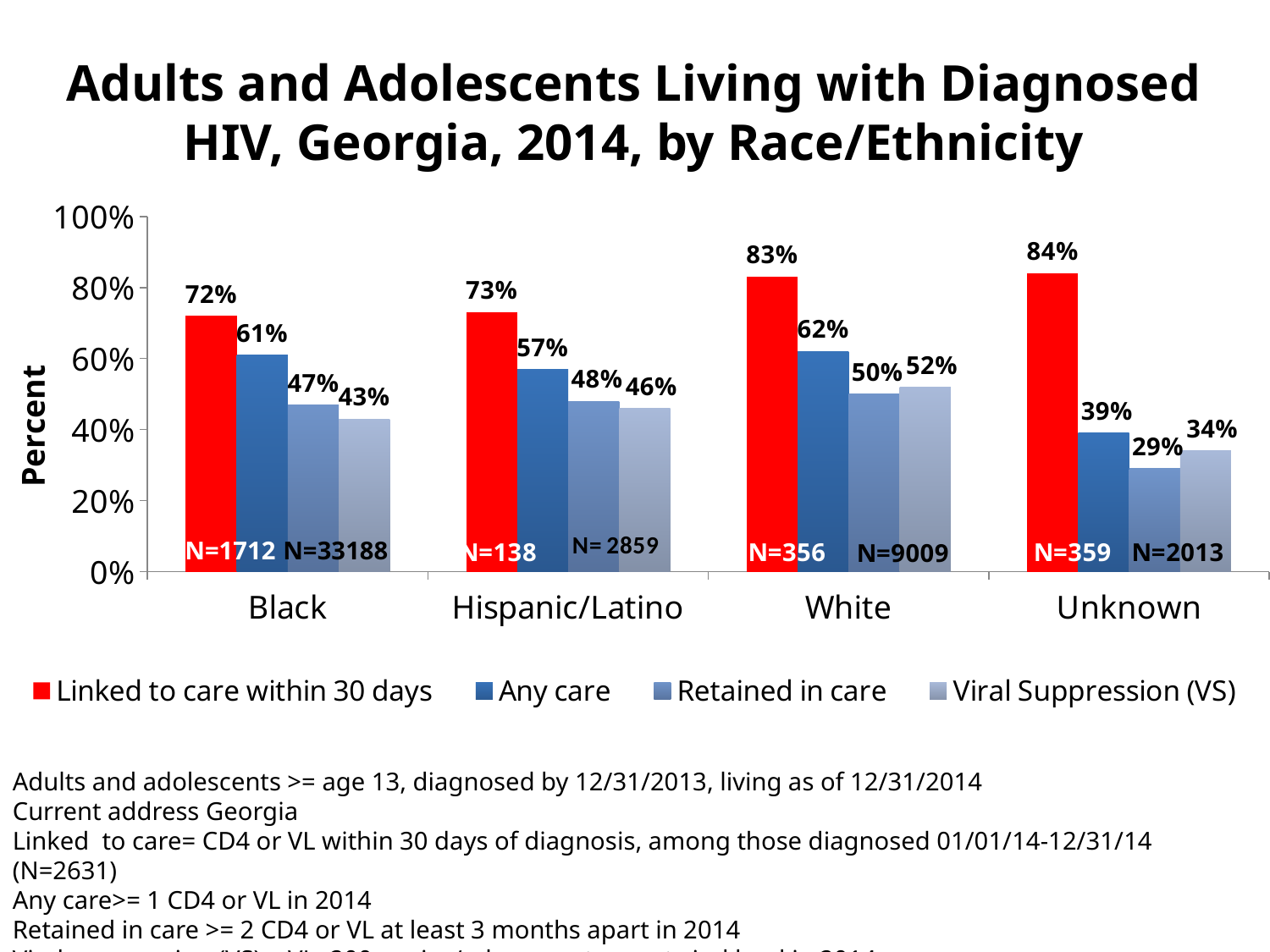
Which series is shown in red in the legend? Linked to care within 30 days How many race/ethnicity categories are shown on the x axis? 4 What kind of chart is shown on the slide? Bar chart Which is larger, the Retained in care value for Black or for Hispanic/Latino? Hispanic/Latino What is the value for Linked to care within 30 days for the Black category? 72% Which race/ethnicity category has the lowest value for Any care? Unknown Which race/ethnicity category has the highest value for Linked to care within 30 days? Unknown What is the label on the y axis? Percent What is the Viral Suppression (VS) value for the White category? 52% How many series does the legend list? 4 What is the Retained in care value for the Unknown category? 29% What is the difference between the Any care values for White and Unknown? 23%